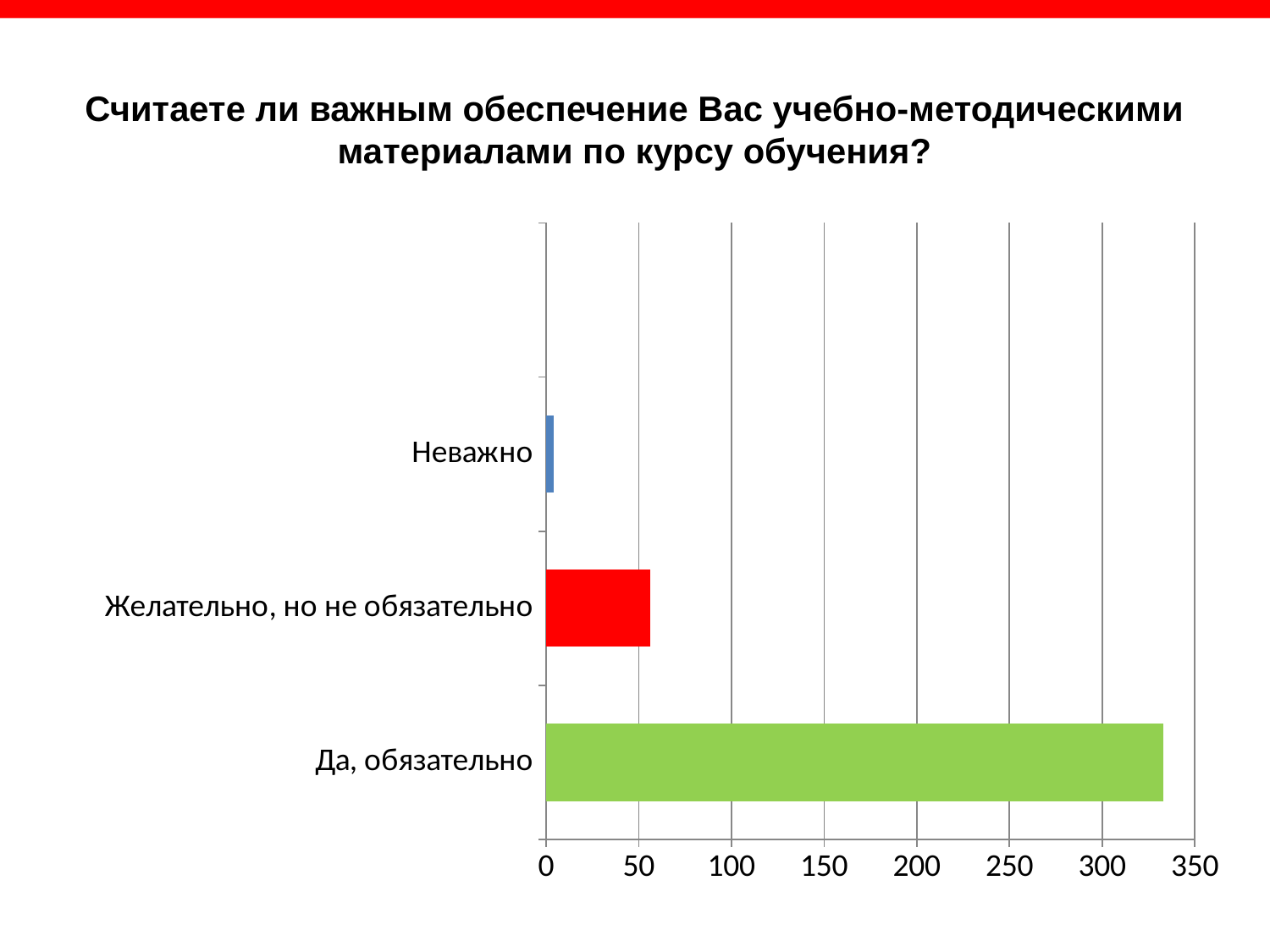
Which category has the highest value? Да, обязательно Which is larger, the value for "Желательно, но не обязательно" or the value for "Неважно"? Желательно, но не обязательно Is the value for "Да, обязательно" greater or less than 350? less Which category has the lowest value? Неважно What kind of chart is shown on the slide? bar chart Is the value for "Да, обязательно" greater or less than 300? greater Is the value for "Неважно" greater or less than 50? less What colour is the bar for "Да, обязательно"? green How many categories are plotted in the chart? 3 What is the highest value shown on the horizontal axis? 350